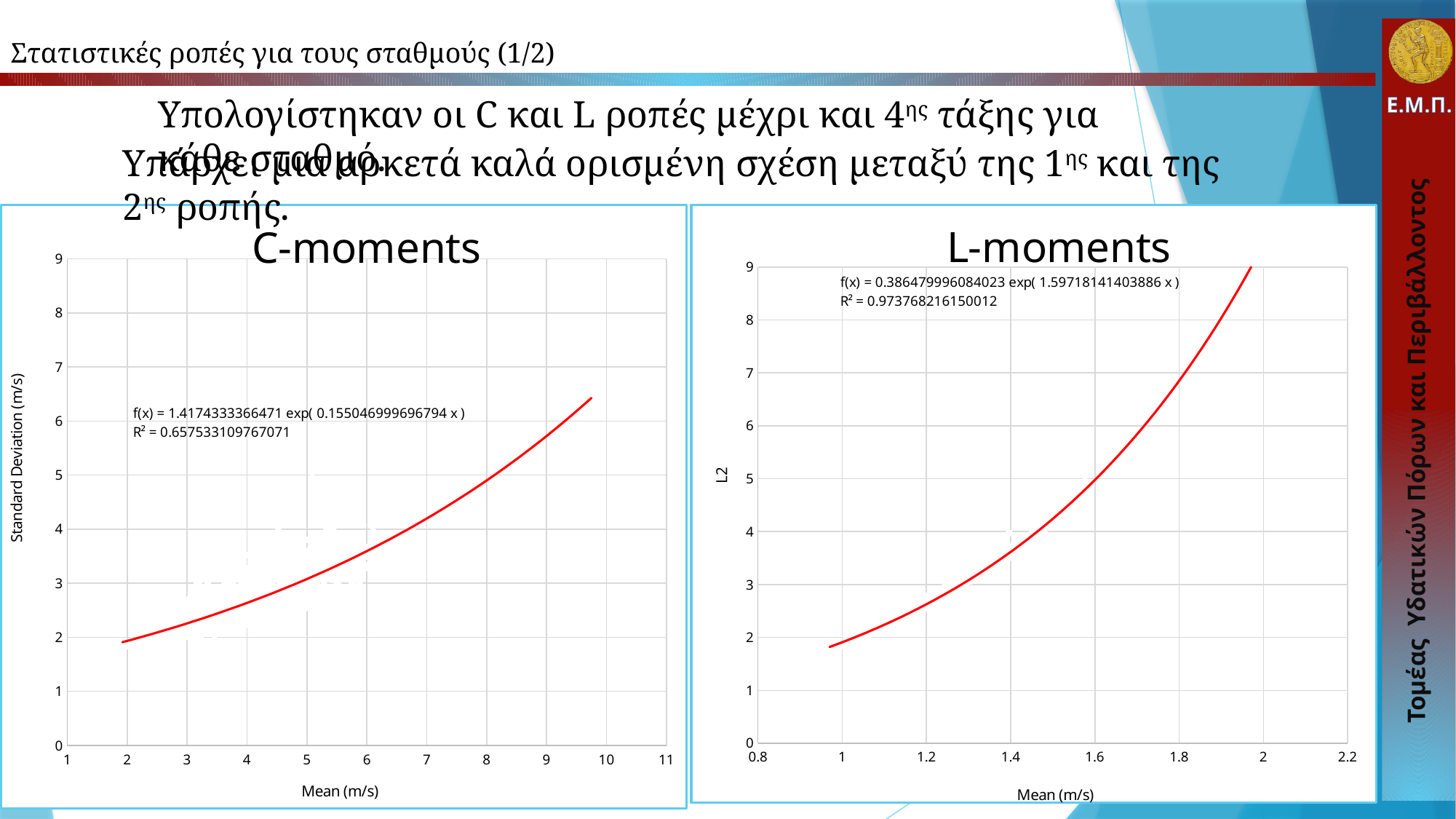
In the L-moments chart, does the fitted curve rise or fall as Mean (m/s) increases? rise In the L-moments chart, what is the R² value printed for the fitted curve? R² = 0.973768216150012 In the C-moments chart, is the fitted curve's value at Mean = 6 m/s greater or less than 4? less What is the title of the chart on the left side of the slide? C-moments What is the title of the chart on the right side of the slide? L-moments In the L-moments chart, is the fitted curve's value at Mean = 1.2 m/s greater or less than 3? less In the L-moments chart, is the fitted curve's value at Mean = 1.8 m/s greater or less than 6? greater In the C-moments chart, what is the label of the vertical axis? Standard Deviation (m/s) Which chart has the higher printed R² value, C-moments or L-moments? L-moments In the L-moments chart, what is the label of the vertical axis? L2 In the C-moments chart, does the fitted curve rise or fall as Mean (m/s) increases? rise In the C-moments chart, what is the R² value printed for the fitted curve? R² = 0.657533109767071